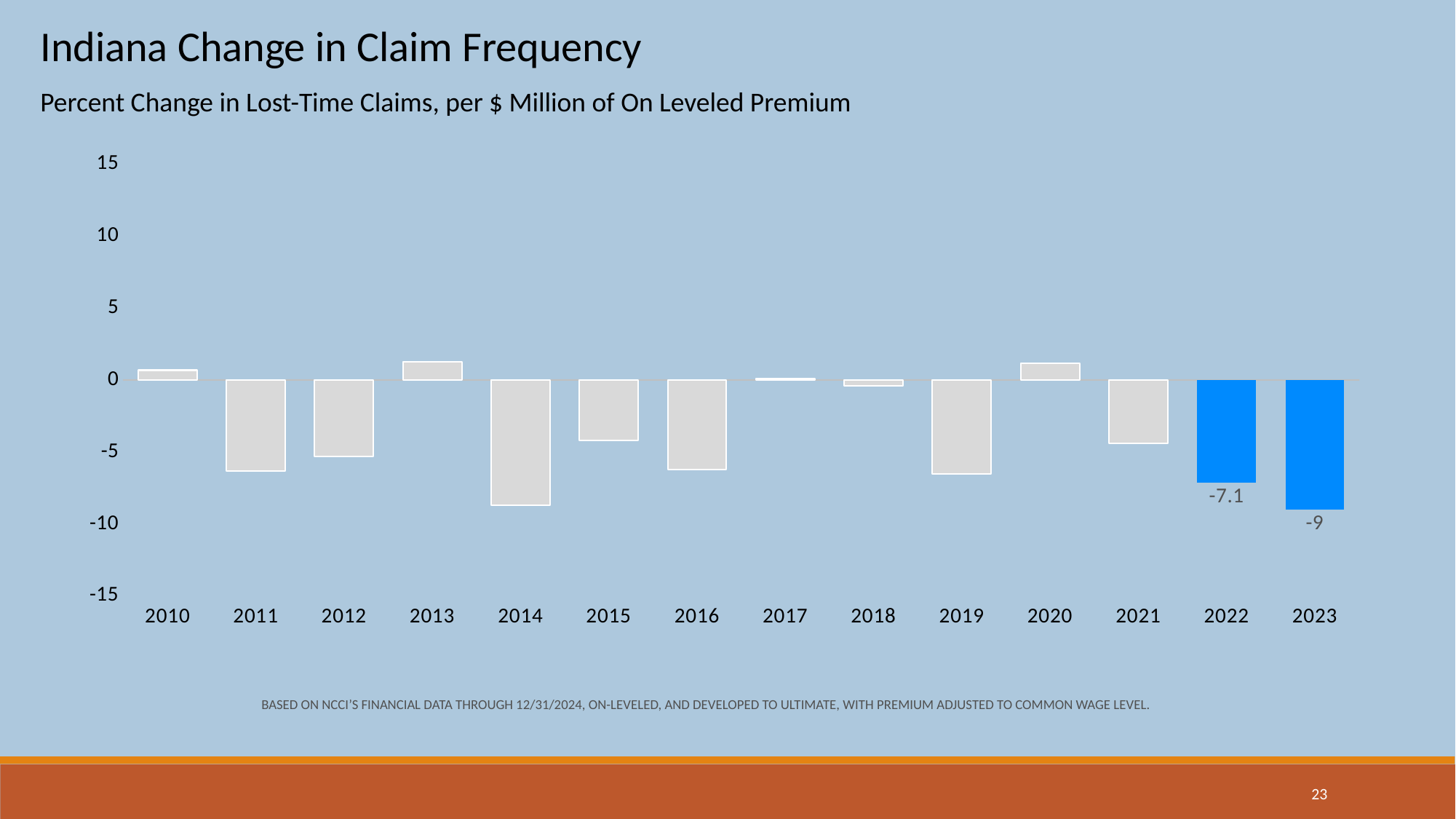
Which year has the larger value, 2010 or 2011? 2010 What is the value for 2023? -9 Is the value for 2019 greater or less than -5? less What kind of chart is shown on the slide? Bar chart How many years are shown on the x axis? 14 What is the difference between the values for 2022 and 2023? 1.9 Is the value for 2014 greater or less than -5? less Is the value for 2015 greater or less than -5? greater What is the value for 2022? -7.1 Which year has the larger value, 2022 or 2023? 2022 Which years are shown with blue bars? 2022 and 2023